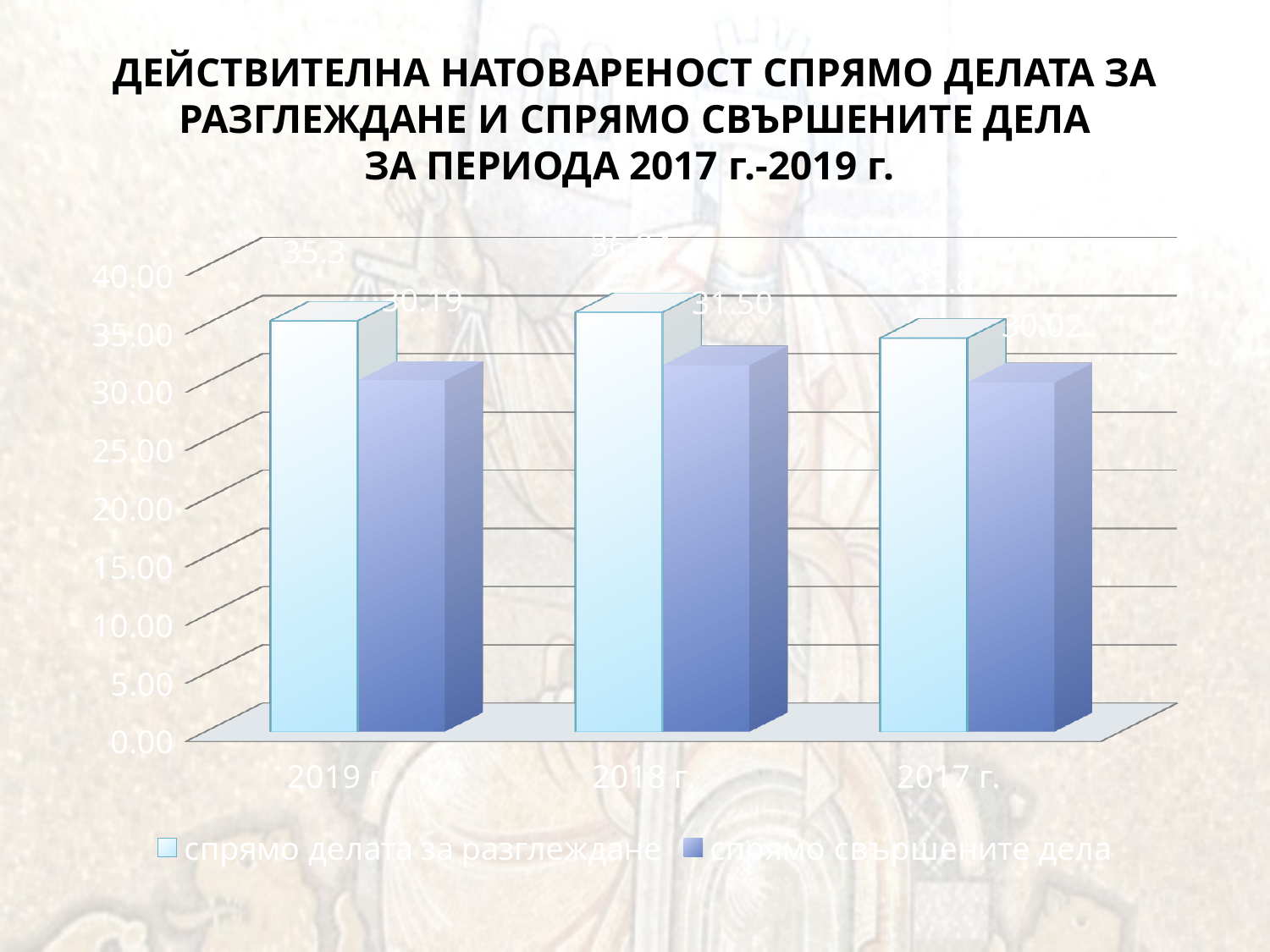
Is the value for "спрямо делата за разглеждане" in 2018 г. greater or less than 35.00? greater How many year categories are shown on the x axis? 3 What is the value for "спрямо делата за разглеждане" in 2019 г.? 35.3 What is the difference between the two series in 2019 г.? 5.11 How many series does the legend list? 2 What type of chart is shown on the slide? bar chart Which series is shown in light blue in the legend? спрямо делата за разглеждане Which year has the lowest value for "спрямо свършените дела"? 2017 г. What is the value for "спрямо свършените дела" in 2019 г.? 30.19 What is the value for "спрямо свършените дела" in 2017 г.? 30.02 What is the value for "спрямо свършените дела" in 2018 г.? 31.50 Which year has the highest value for "спрямо свършените дела"? 2018 г.